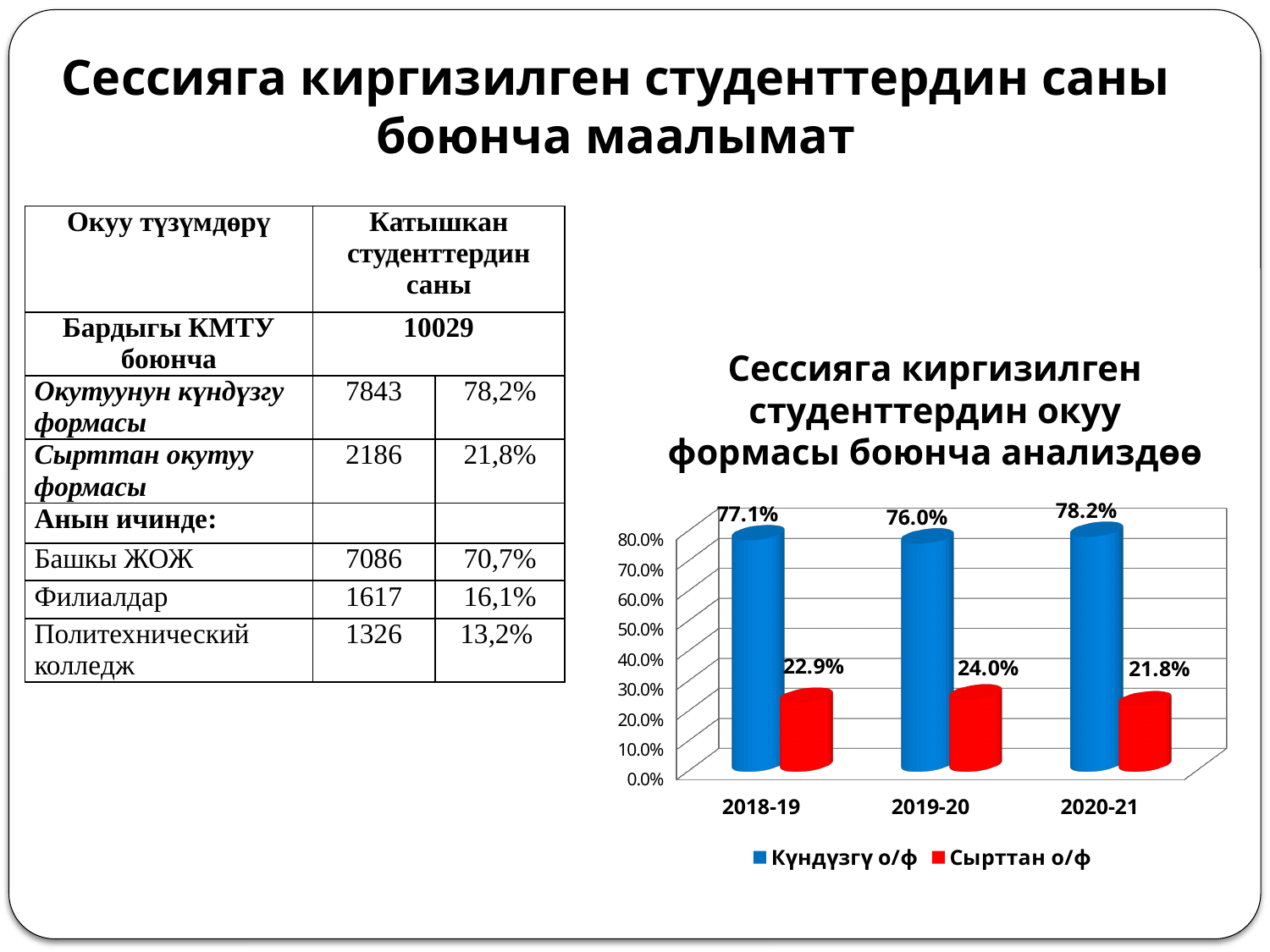
In which year is the Сырттан о/ф value lowest? 2020-21 What is the difference between the Күндүзгү о/ф and Сырттан о/ф values in 2019-20? 52.0% Which is larger in 2018-19: Күндүзгү о/ф or Сырттан о/ф? Күндүзгү о/ф How many year categories are shown on the x axis? 3 What is the value for Сырттан о/ф in 2019-20? 24.0% In which year is the Күндүзгү о/ф value highest? 2020-21 What is the value for Күндүзгү о/ф in 2020-21? 78.2% What kind of chart is shown on the slide? Bar chart How many series does the legend list? 2 What is the value for Күндүзгү о/ф in 2018-19? 77.1% What is the title of the chart? Сессияга киргизилген студенттердин окуу формасы боюнча анализдөө What is the value for Сырттан о/ф in 2020-21? 21.8%